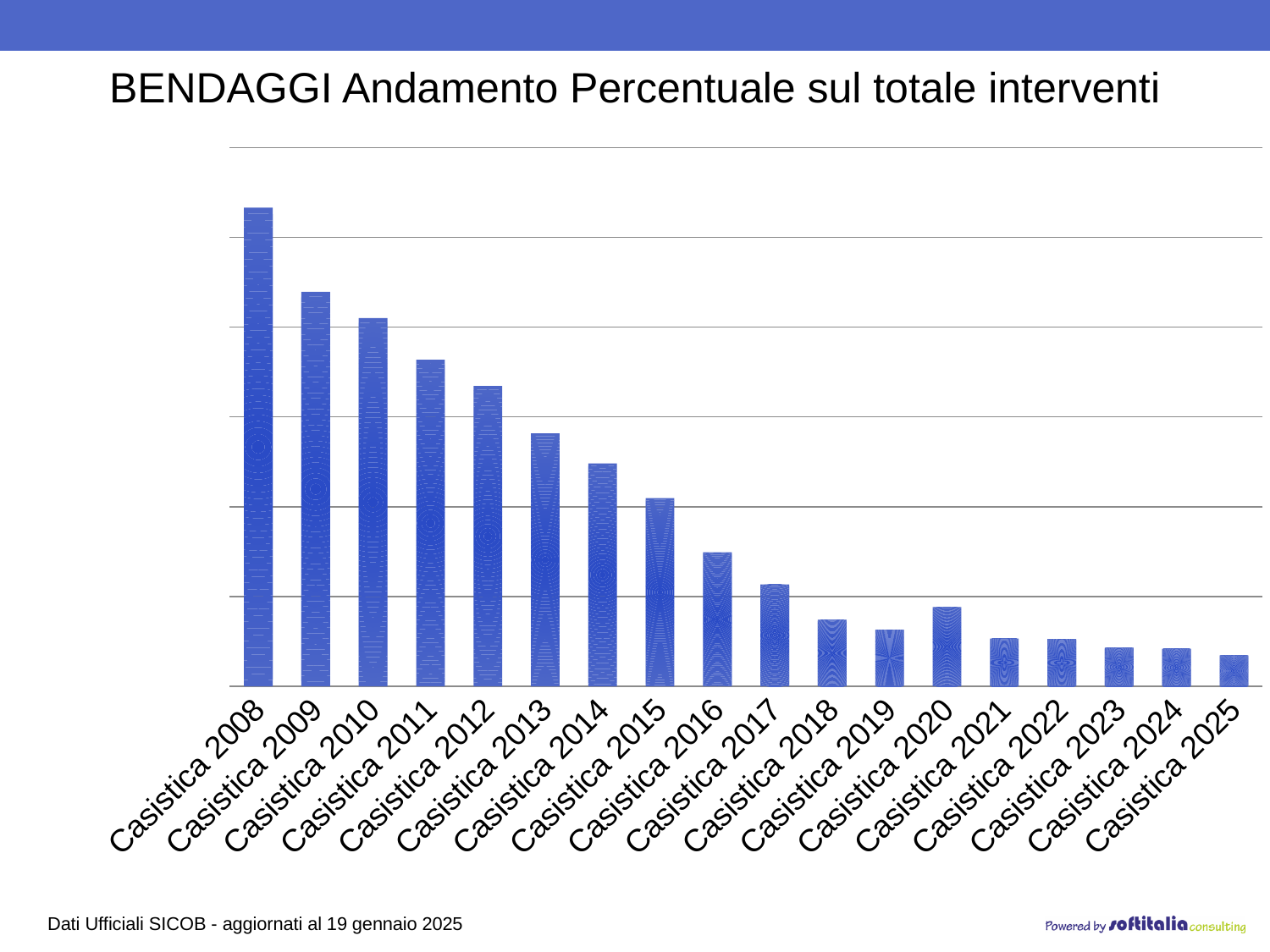
Which category has the highest bar? Casistica 2008 How many categories (bars) are plotted in the chart? 18 What kind of chart is shown on the slide? Bar chart Which is larger, the value for Casistica 2010 or Casistica 2015? Casistica 2010 What is the title of the chart? BENDAGGI Andamento Percentuale sul totale interventi Do the values generally rise or fall from Casistica 2008 to Casistica 2025? Fall Which is larger, the value for Casistica 2019 or Casistica 2020? Casistica 2020 Which is larger, the value for Casistica 2008 or Casistica 2009? Casistica 2008 What is the first year category shown on the x axis? Casistica 2008